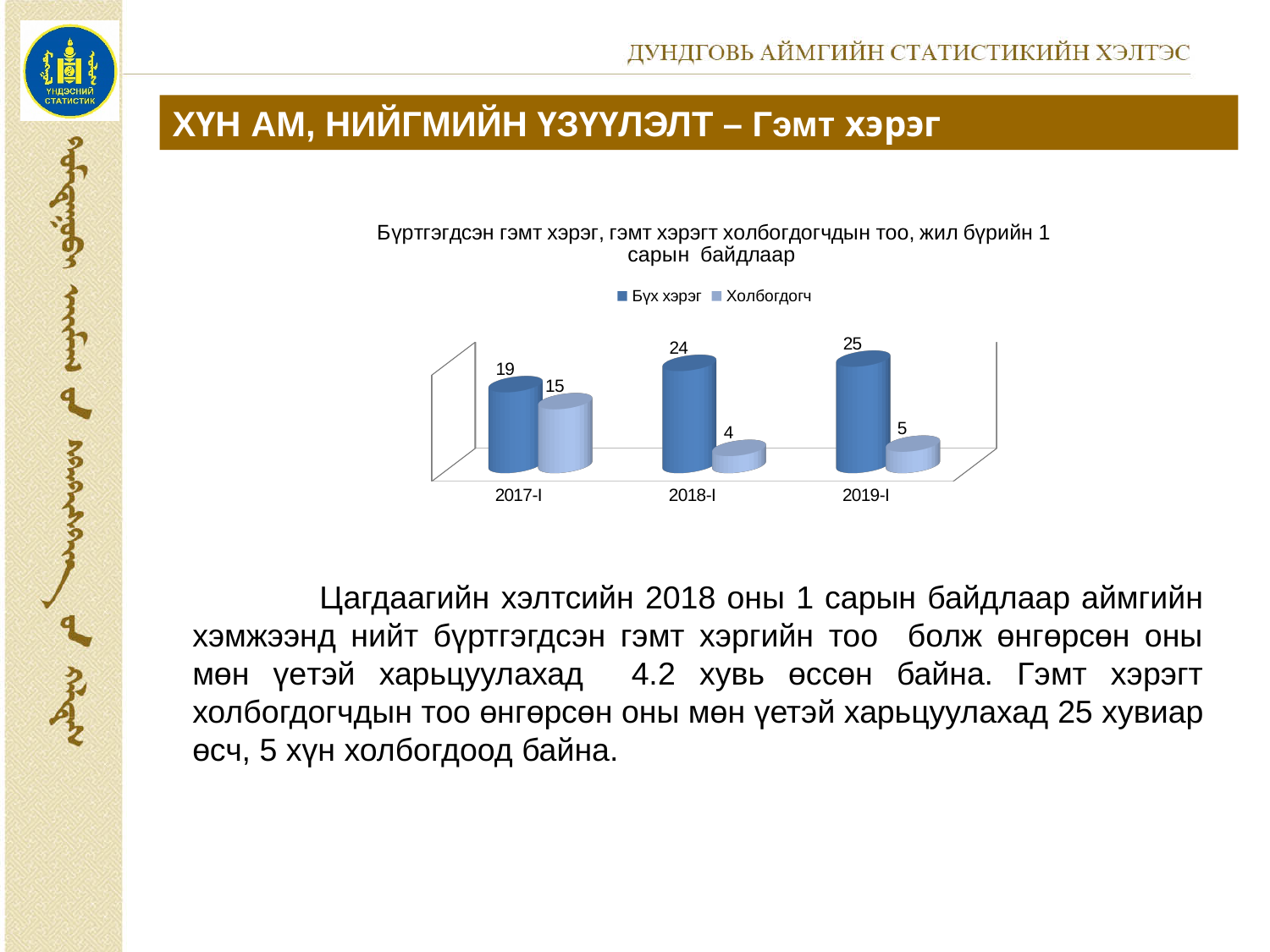
What is the value of Холбогдогч for 2018-I? 4 Which period has the highest value for Бүх хэрэг? 2019-I Which period has the lowest value for Холбогдогч? 2018-I How many series does the legend list? 2 What is the value of Бүх хэрэг for 2017-I? 19 Does the value of Бүх хэрэг rise or fall from 2017-I to 2019-I? Rise Which is larger: Холбогдогч in 2017-I or Холбогдогч in 2019-I? 2017-I What are the two series named in the legend? Бүх хэрэг and Холбогдогч What is the difference between Бүх хэрэг and Холбогдогч in 2019-I? 20 What is the value of Бүх хэрэг for 2019-I? 25 What kind of chart is shown on the slide? Bar chart How many periods are shown on the x axis? 3